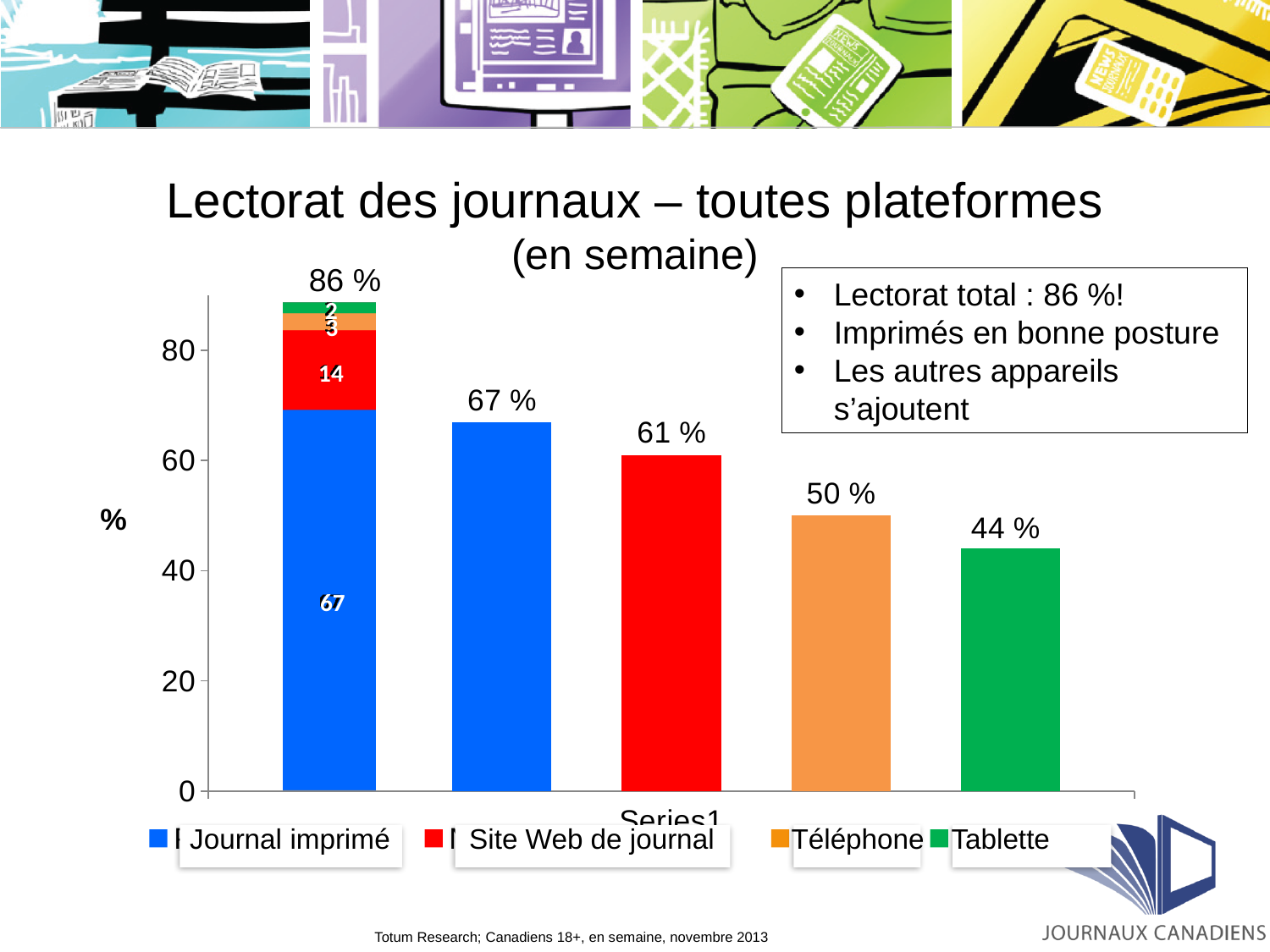
How many entries does the legend list? 4 What is the value shown for Tablette? 44 % What is the total shown on the stacked bar at the left of the chart? 86 % What is the value shown for Site Web de journal? 61 % What is the value shown for Téléphone? 50 % What kind of chart is shown on the slide? bar chart What is the difference between the values for Journal imprimé and Tablette? 23 % Which is larger, the value for Site Web de journal or the value for Téléphone? Site Web de journal What is the title of the chart? Lectorat des journaux – toutes plateformes (en semaine) Which of the four platform bars has the highest value? Journal imprimé What is the value shown for Journal imprimé? 67 % Which of the four platform bars has the lowest value? Tablette